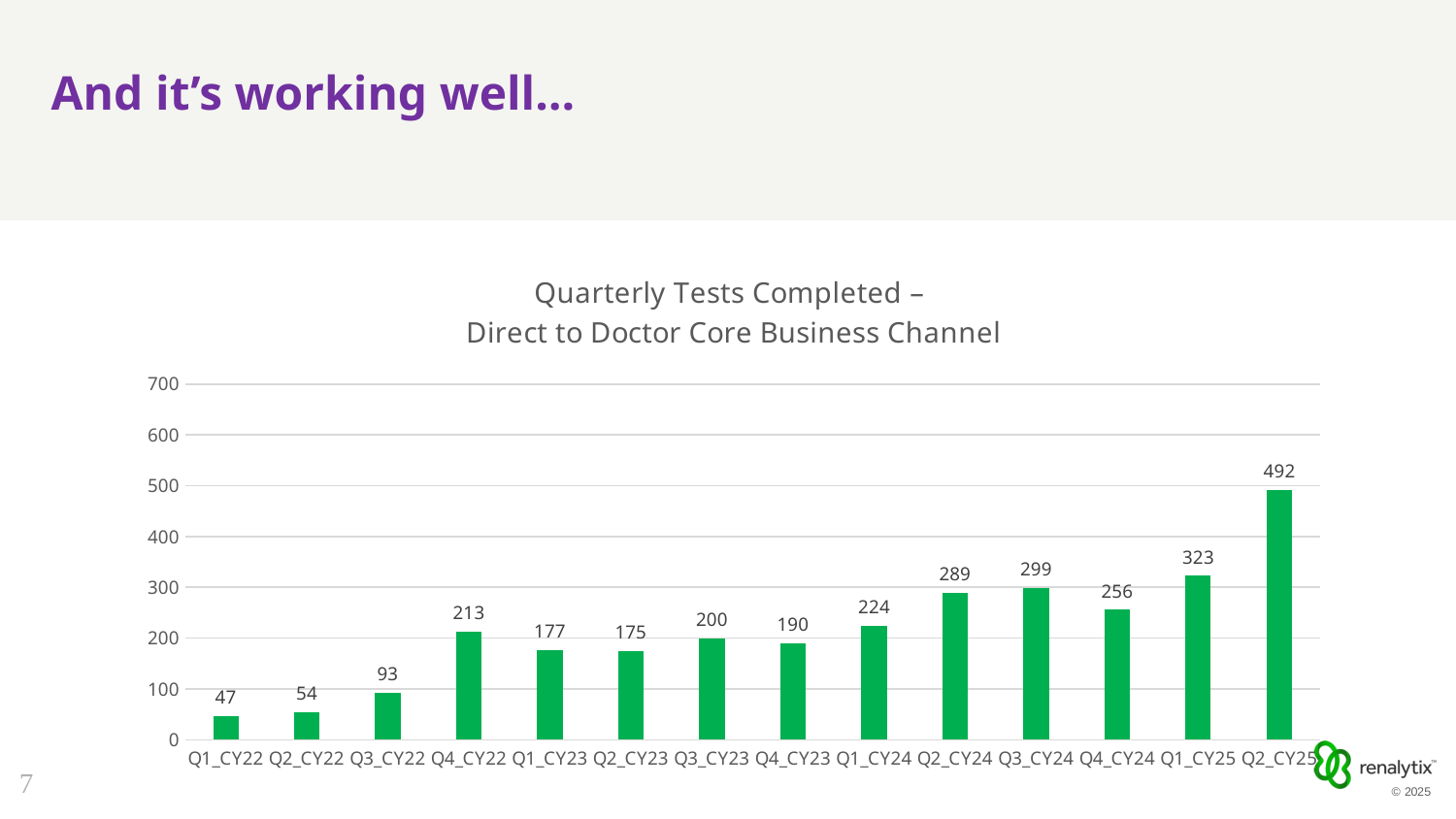
What kind of chart is shown on the slide? Bar chart What is the value for Q1_CY25? 323 What is the difference between the values for Q4_CY22 and Q3_CY22? 120 What is the value for Q4_CY22? 213 Which quarter has the lowest number of tests completed? Q1_CY22 What is the title of the chart? Quarterly Tests Completed – Direct to Doctor Core Business Channel Is the value for Q2_CY25 greater or less than 400? greater How many quarters are shown on the x axis? 14 Which quarter has the highest number of tests completed? Q2_CY25 What is the difference between the values for Q2_CY25 and Q1_CY25? 169 Which is larger, the value for Q3_CY24 or the value for Q4_CY24? Q3_CY24 What is the value for Q3_CY24? 299